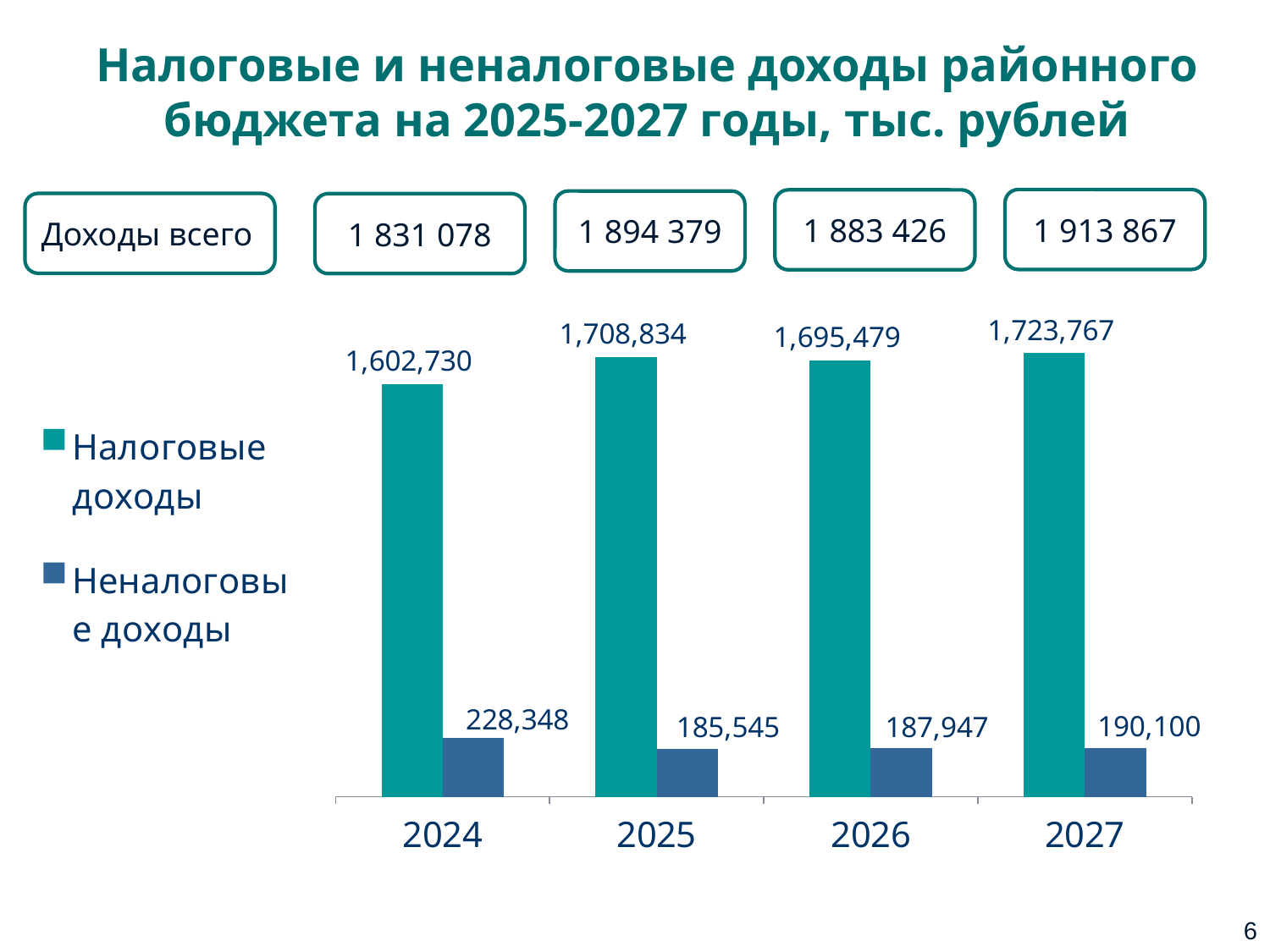
In which year are Неналоговые доходы lowest? 2025 How many series does the legend list? 2 Which is larger: Неналоговые доходы in 2024 or in 2025? 2024 In which year are Неналоговые доходы highest? 2024 How many years are shown on the x axis of the chart? 4 What is the value of Налоговые доходы for 2024? 1,602,730 What is the value of Неналоговые доходы for 2027? 190,100 What is the difference between Налоговые доходы in 2027 and in 2024? 121,037 Do Неналоговые доходы rise or fall from 2025 to 2027? rise What type of chart is shown on the slide? bar chart What is the value of Налоговые доходы for 2026? 1,695,479 In which year are Налоговые доходы highest? 2027